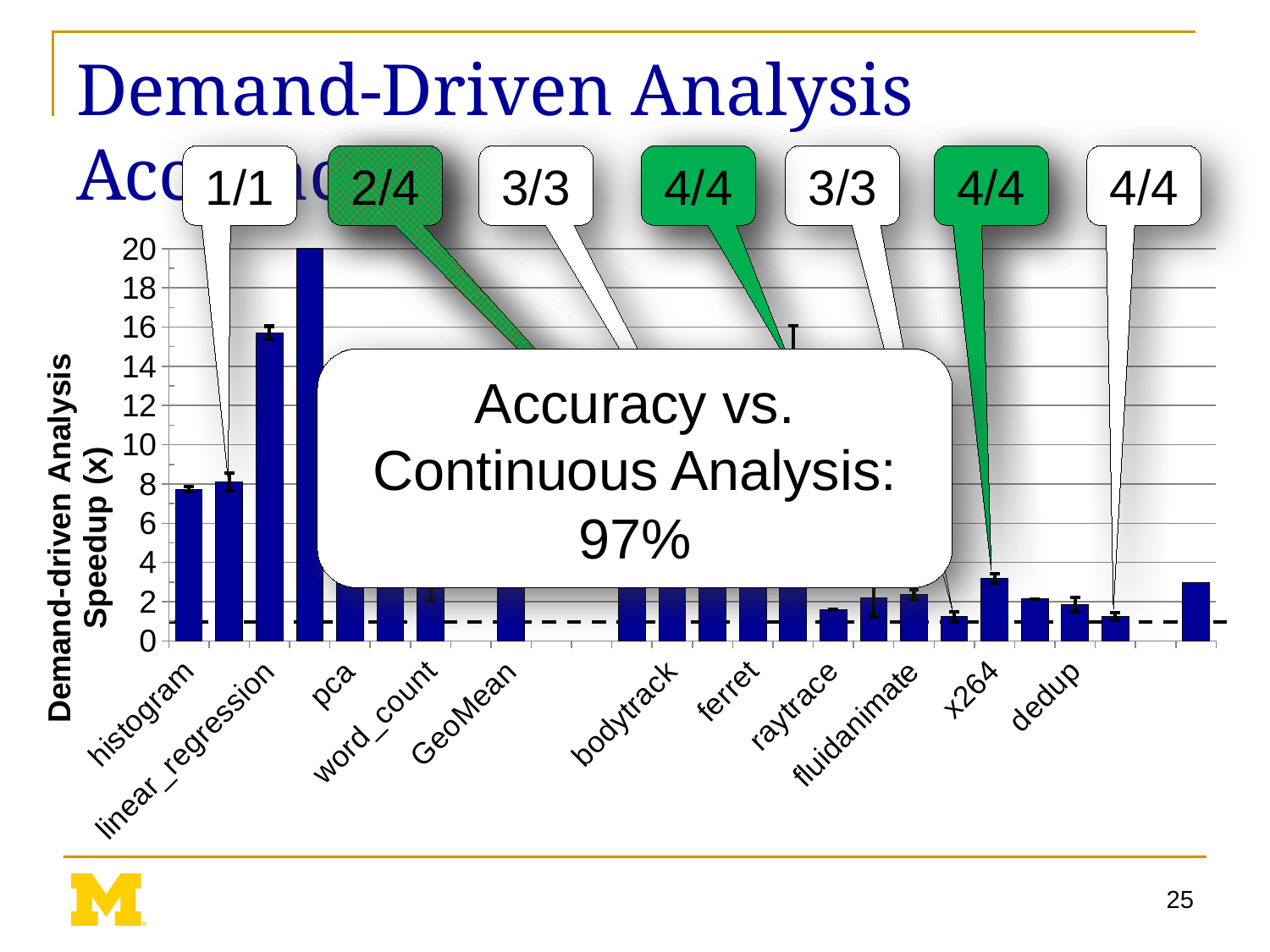
Is the value for histogram greater or less than 10? less Which has the larger speedup, histogram or x264? histogram Is the value for raytrace greater or less than 4? less What kind of chart is shown on the slide? bar chart Is the value for x264 greater or less than 6? less Which has the larger speedup, histogram or dedup? histogram What accuracy versus continuous analysis is stated in the large callout over the chart? 97% What is the label of the vertical axis of the chart? Demand-driven Analysis Speedup (x)